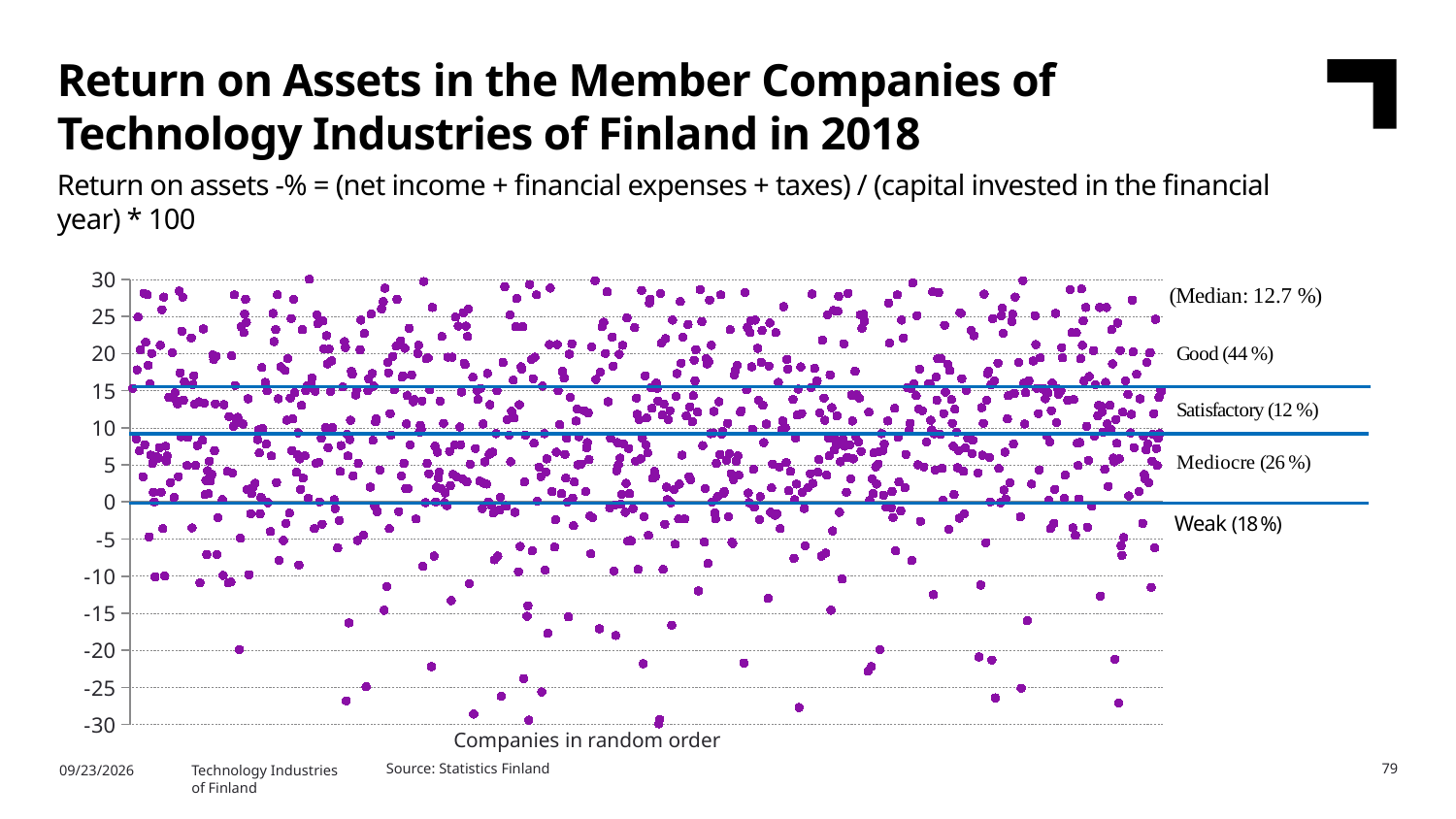
What share of companies falls into the 'Weak' category? 18 % What share of companies falls into the 'Mediocre' category? 26 % Which category has the largest share of companies? Good What is the median return on assets shown on the chart? 12.7 % What share of companies falls into the 'Good' category? 44 % Which category has the smallest share of companies? Satisfactory What share of companies falls into the 'Satisfactory' category? 12 % What kind of chart is shown on the slide? scatter chart What is the highest value shown on the y axis? 30 What is the difference in percentage points between the 'Good' share and the 'Mediocre' share? 18 Which category has a larger share of companies, 'Mediocre' or 'Weak'? Mediocre What is the label of the x axis? Companies in random order